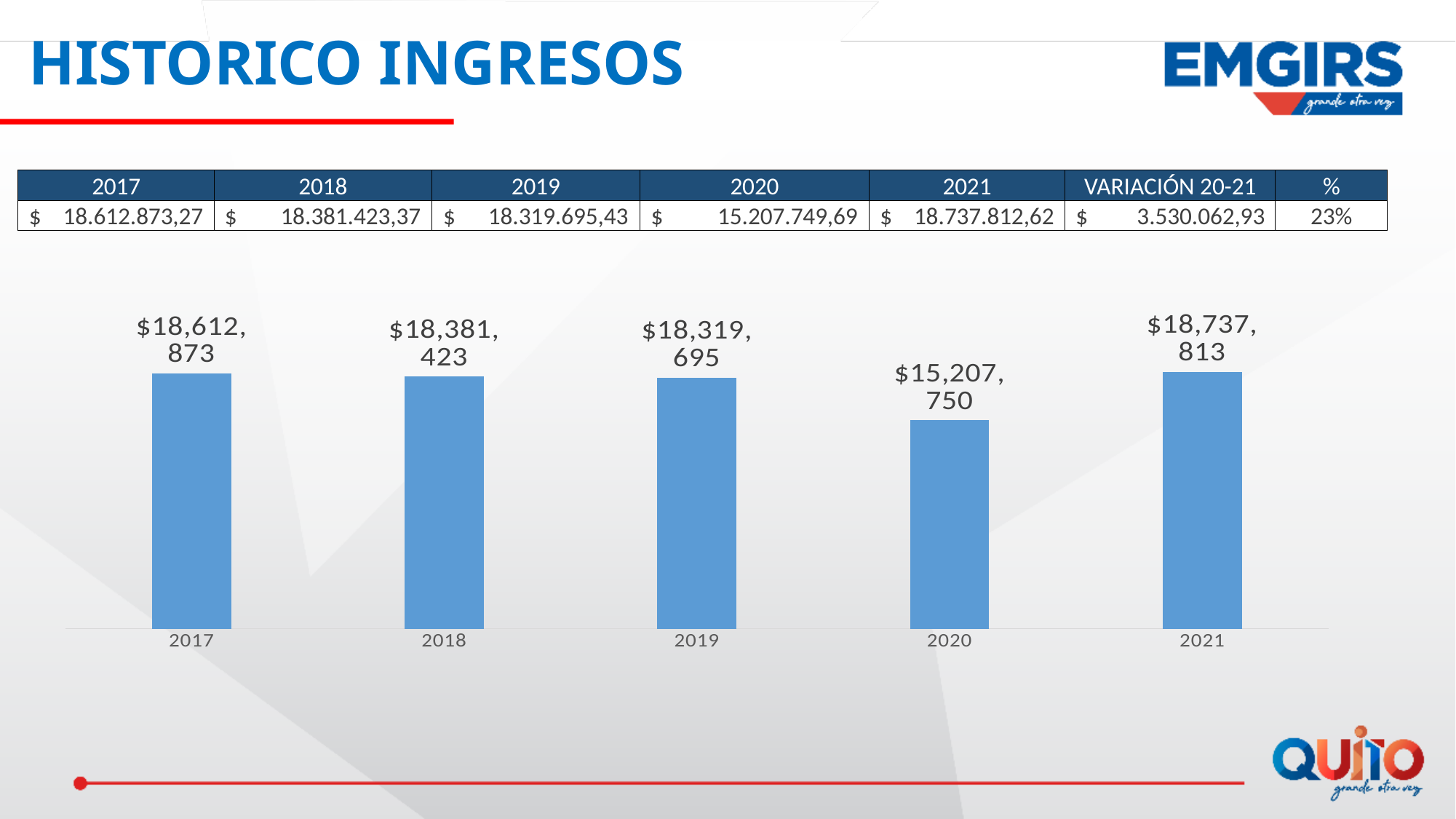
What is the difference between the 2017 and 2018 values in the bar chart? $231,450 How many years are plotted in the bar chart? 5 Do the values in the bar chart rise or fall from 2017 to 2019? Fall What is the value shown for 2020 in the bar chart? $15,207,750 Which year has the highest value in the bar chart? 2021 What is the value shown for 2021 in the bar chart? $18,737,813 What is the value shown for 2017 in the bar chart? $18,612,873 What kind of chart is shown on the slide? Bar chart What is the value shown for 2019 in the bar chart? $18,319,695 Which is larger in the bar chart, the value for 2017 or the value for 2020? 2017 Which year has the lowest value in the bar chart? 2020 What is the difference between the 2021 and 2020 values in the bar chart? $3,530,063